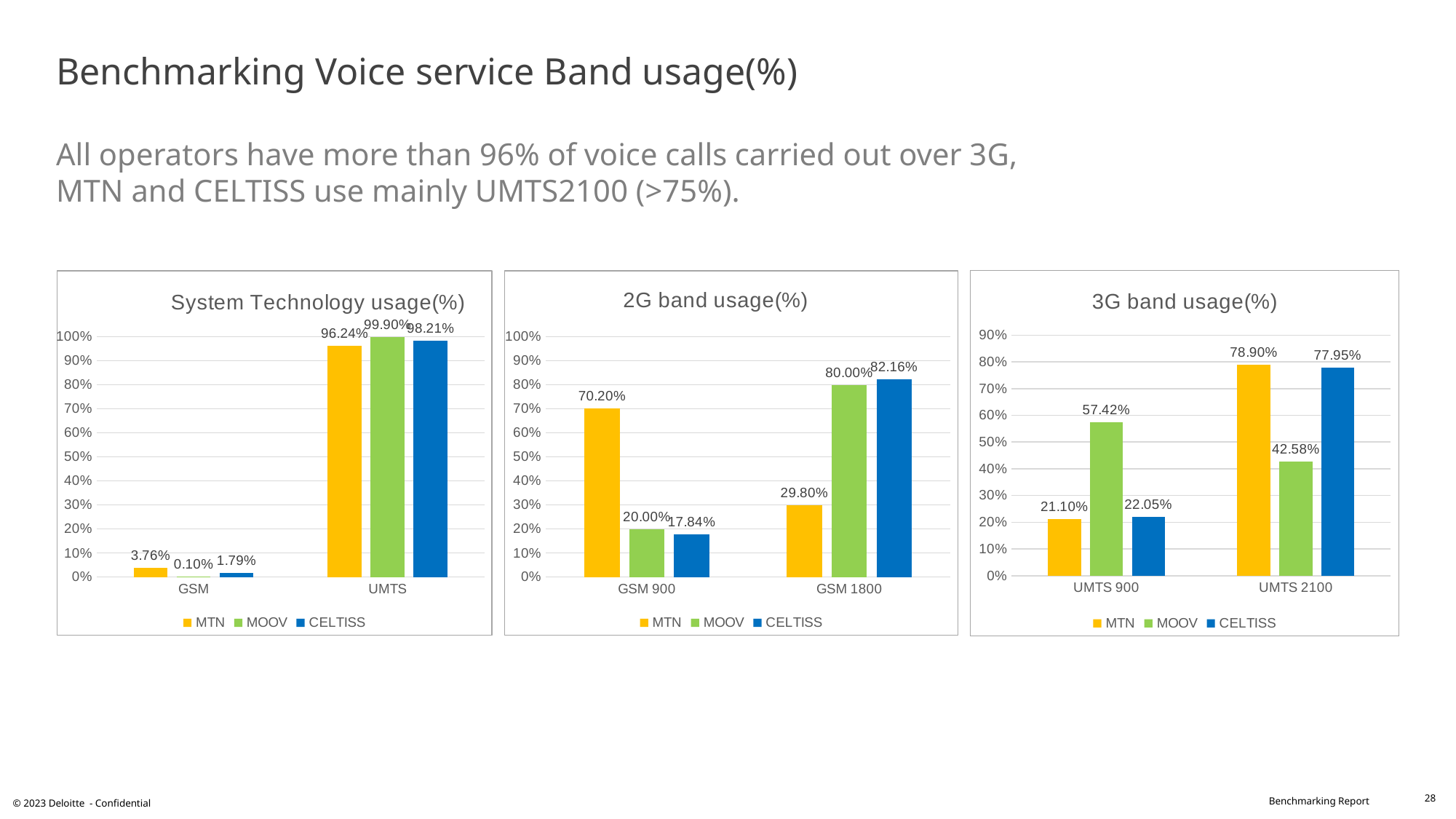
What kind of chart is the "System Technology usage(%)" chart? Bar chart How many categories are shown on the x axis of the "3G band usage(%)" chart? 2 In the "System Technology usage(%)" chart, what is the value for MOOV at UMTS? 99.90% How many series does the legend of the "2G band usage(%)" chart list? 3 In the "3G band usage(%)" chart, what is the value for CELTISS at UMTS 2100? 77.95% In the "3G band usage(%)" chart, which operator has the highest value at UMTS 900? MOOV In the "2G band usage(%)" chart, what is the value for MTN at GSM 900? 70.20% In the "3G band usage(%)" chart, what is the difference between MOOV's values at UMTS 900 and UMTS 2100? 14.84% In the "2G band usage(%)" chart, which operator has the highest value at GSM 1800? CELTISS In the "System Technology usage(%)" chart, which operator has the lowest value at GSM? MOOV In the "3G band usage(%)" chart, which is larger at UMTS 2100: MTN or MOOV? MTN In the "2G band usage(%)" chart, what is the difference between MTN's values at GSM 900 and GSM 1800? 40.40%